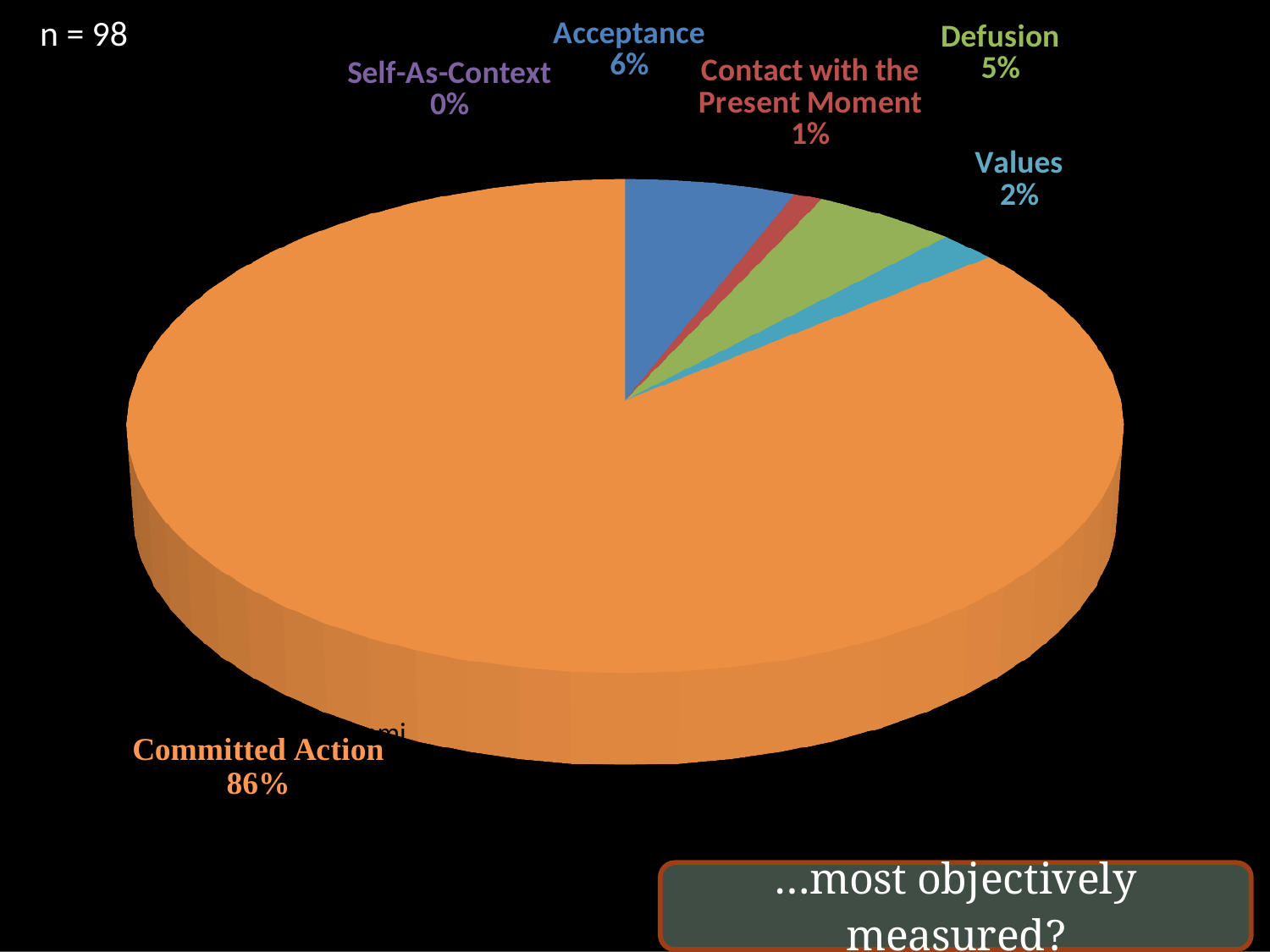
What kind of chart is shown on the slide? pie chart Which is larger, Acceptance or Defusion? Acceptance What is the difference in percentage points between Committed Action and Acceptance? 80 Which category has the largest share of the pie? Committed Action What is the value shown for Contact with the Present Moment? 1% What is the value shown for Self-As-Context? 0% What share of the pie does Committed Action represent? 86% What is the value shown for Values? 2% How many categories are labelled on the pie chart? 6 Which category has the smallest share of the pie? Self-As-Context What is the value shown for Defusion? 5% What is the value shown for Acceptance? 6%